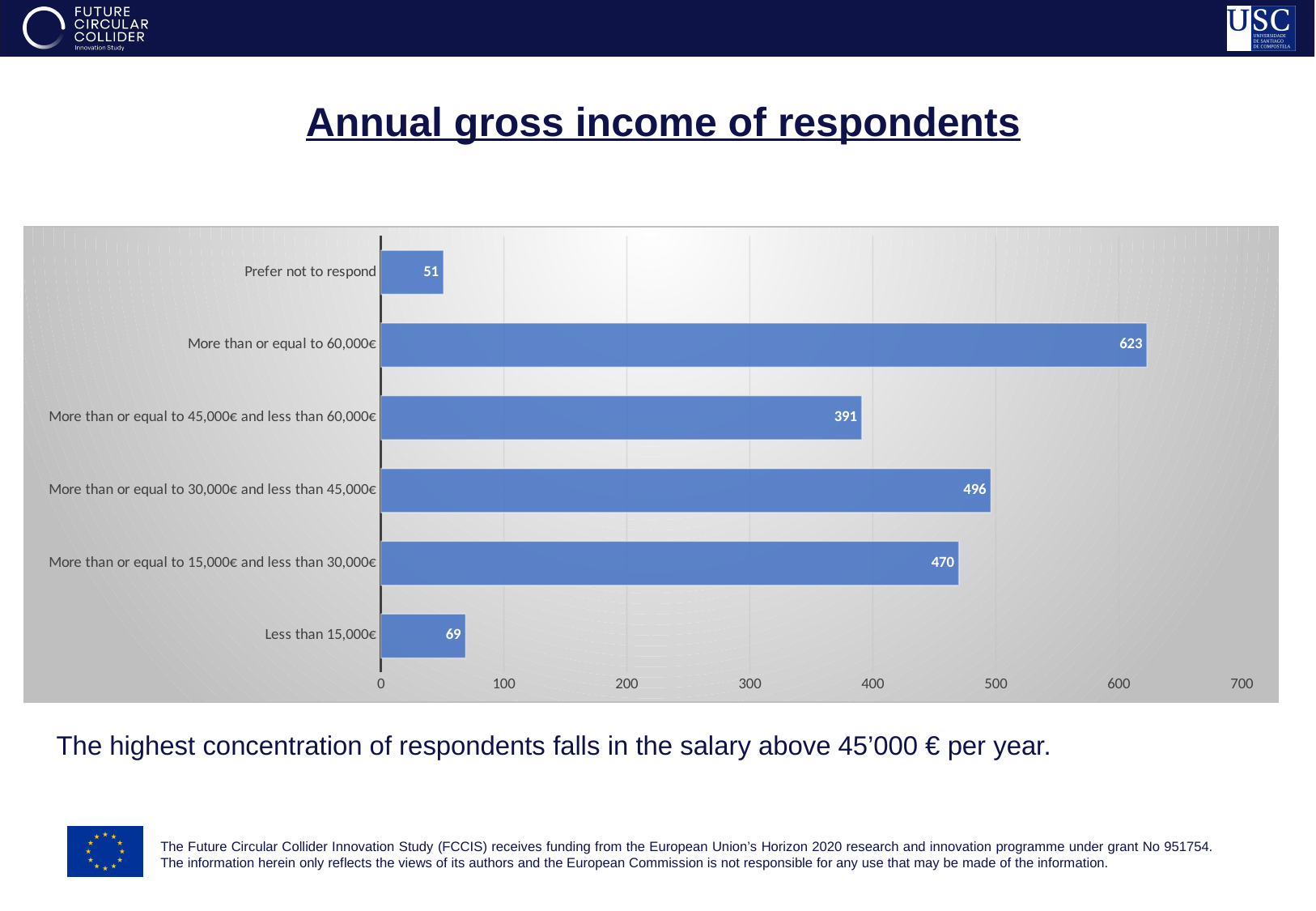
What is the value for the 'Less than 15,000€' category? 69 What is the difference between the 'More than or equal to 60,000€' category and the 'More than or equal to 45,000€ and less than 60,000€' category? 232 Which income category has the highest number of respondents? More than or equal to 60,000€ What is the value for 'More than or equal to 30,000€ and less than 45,000€'? 496 Which category has the lowest value on the chart? Prefer not to respond What type of chart is shown on the slide? Bar chart How many respondents reported an annual gross income of more than or equal to 60,000€? 623 What is the title of the slide containing the chart? Annual gross income of respondents Is the value for 'More than or equal to 30,000€ and less than 45,000€' greater or less than 400? greater How many respondents chose 'Prefer not to respond'? 51 How many income categories are shown on the chart? 6 Which is larger: the value for 'More than or equal to 15,000€ and less than 30,000€' or the value for 'More than or equal to 45,000€ and less than 60,000€'? More than or equal to 15,000€ and less than 30,000€